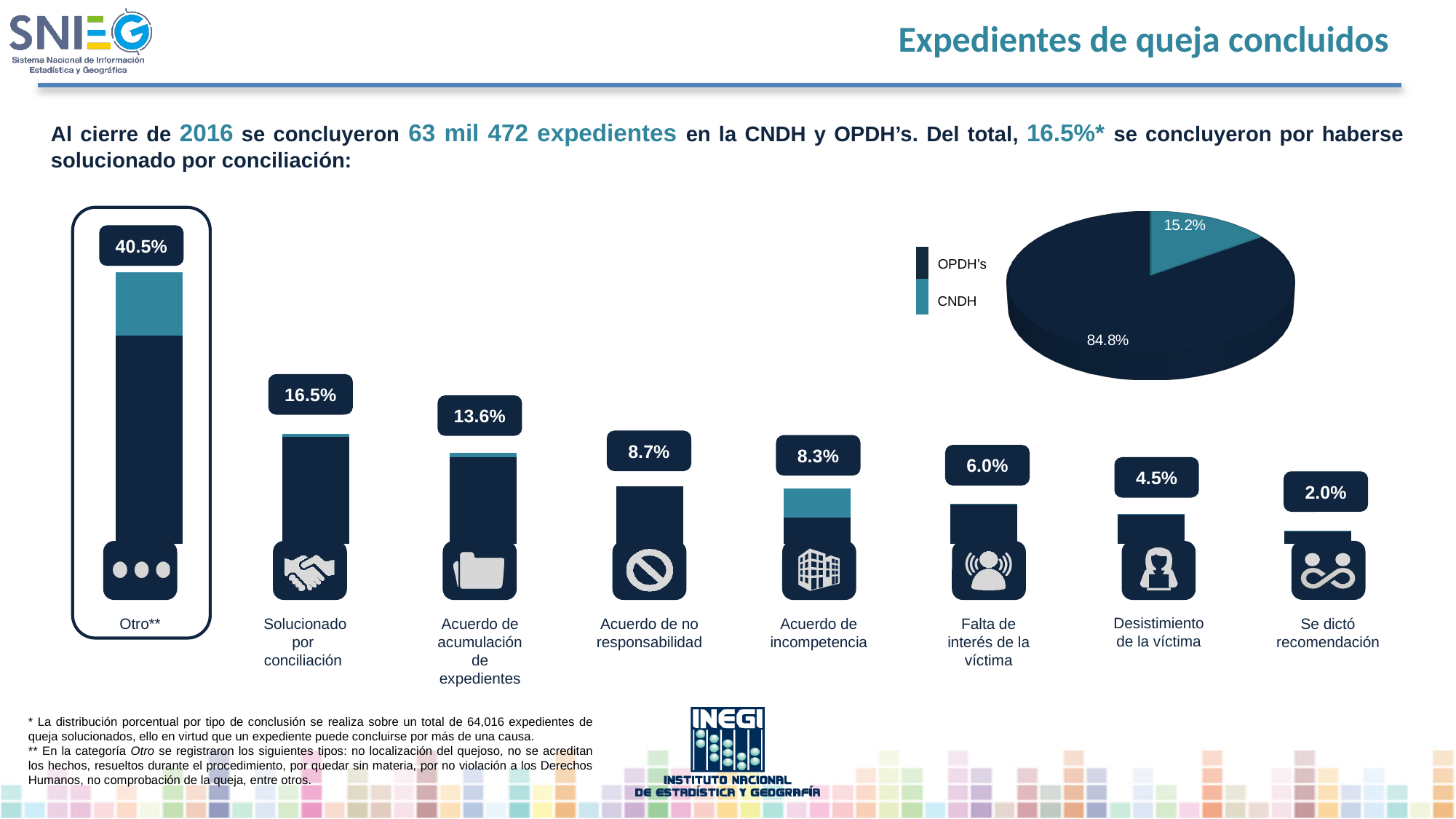
How many entries does the legend of the pie chart list? 2 In the bar chart, which is larger: 'Falta de interés de la víctima' or 'Desistimiento de la víctima'? Falta de interés de la víctima In the bar chart, what percentage is shown for 'Otro**'? 40.5% In the bar chart, what percentage is shown for 'Acuerdo de incompetencia'? 8.3% In the pie chart, what share is shown for OPDH's? 84.8% In the bar chart, what percentage is shown for 'Solucionado por conciliación'? 16.5% In the bar chart, which category has the highest percentage? Otro** Do the values in the bar chart rise or fall from left to right? fall In the bar chart, what is the difference between 'Acuerdo de acumulación de expedientes' and 'Acuerdo de no responsabilidad'? 4.9% In the pie chart, what share is shown for CNDH? 15.2% How many categories does the bar chart show? 8 In the bar chart, which category has the lowest percentage? Se dictó recomendación